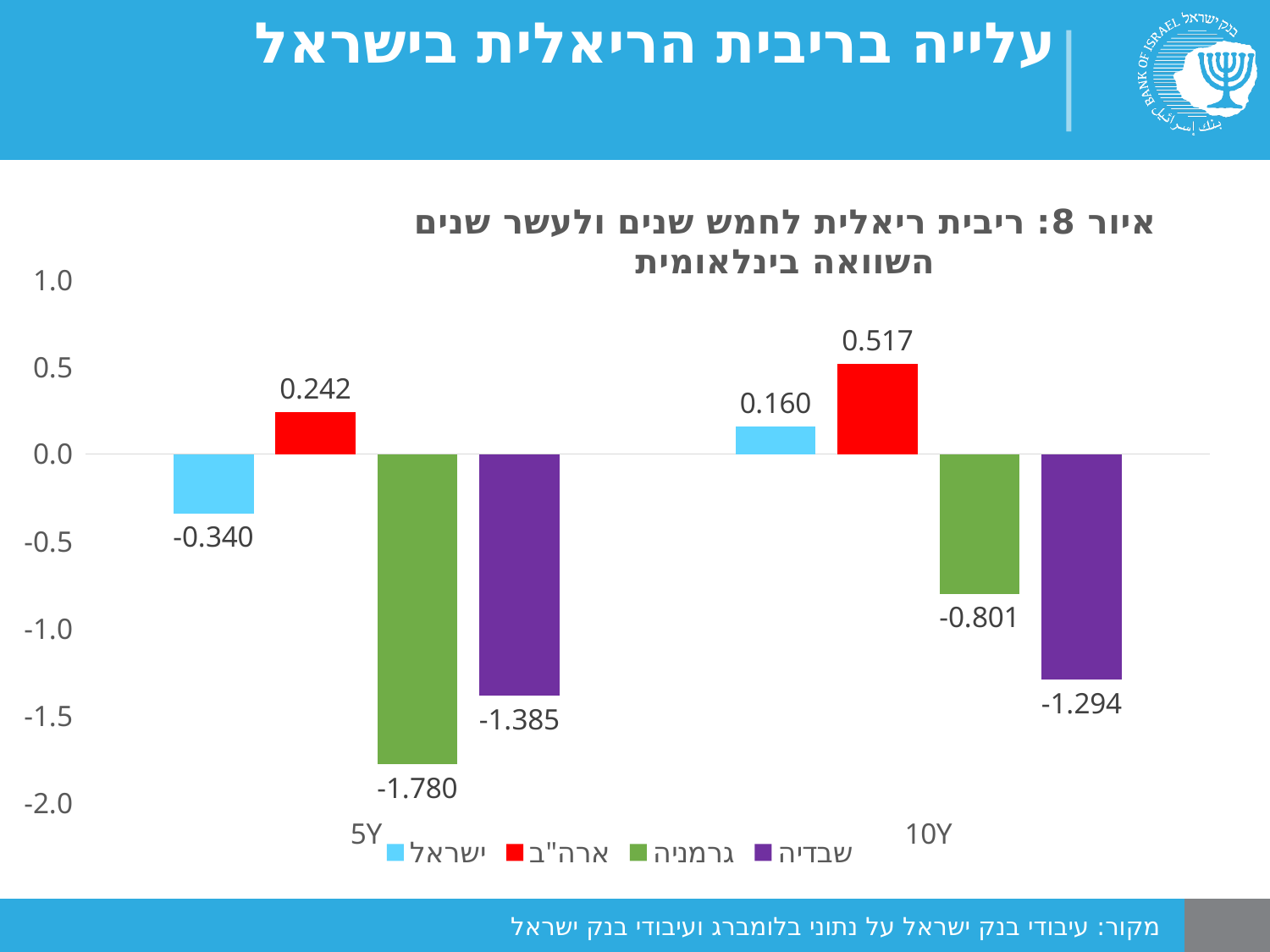
What is the difference between the ארה"ב (USA) values for 10Y and 5Y? 0.275 What is the value for שבדיה (Sweden) in the 10Y group? -1.294 What kind of chart is shown on the slide? Bar chart Which colour represents גרמניה (Germany) in the chart? Green Which series has the lowest value in the 5Y group? גרמניה (Germany) How many category groups are shown on the x axis? 2 What is the value for ישראל (Israel) in the 5Y group? -0.340 How many series does the legend list? 4 Which series has the highest value in the 10Y group? ארה"ב (USA) What is the value for ארה"ב (USA) in the 10Y group? 0.517 Which is larger: the ישראל (Israel) value for 5Y or for 10Y? 10Y What is the value for גרמניה (Germany) in the 5Y group? -1.780